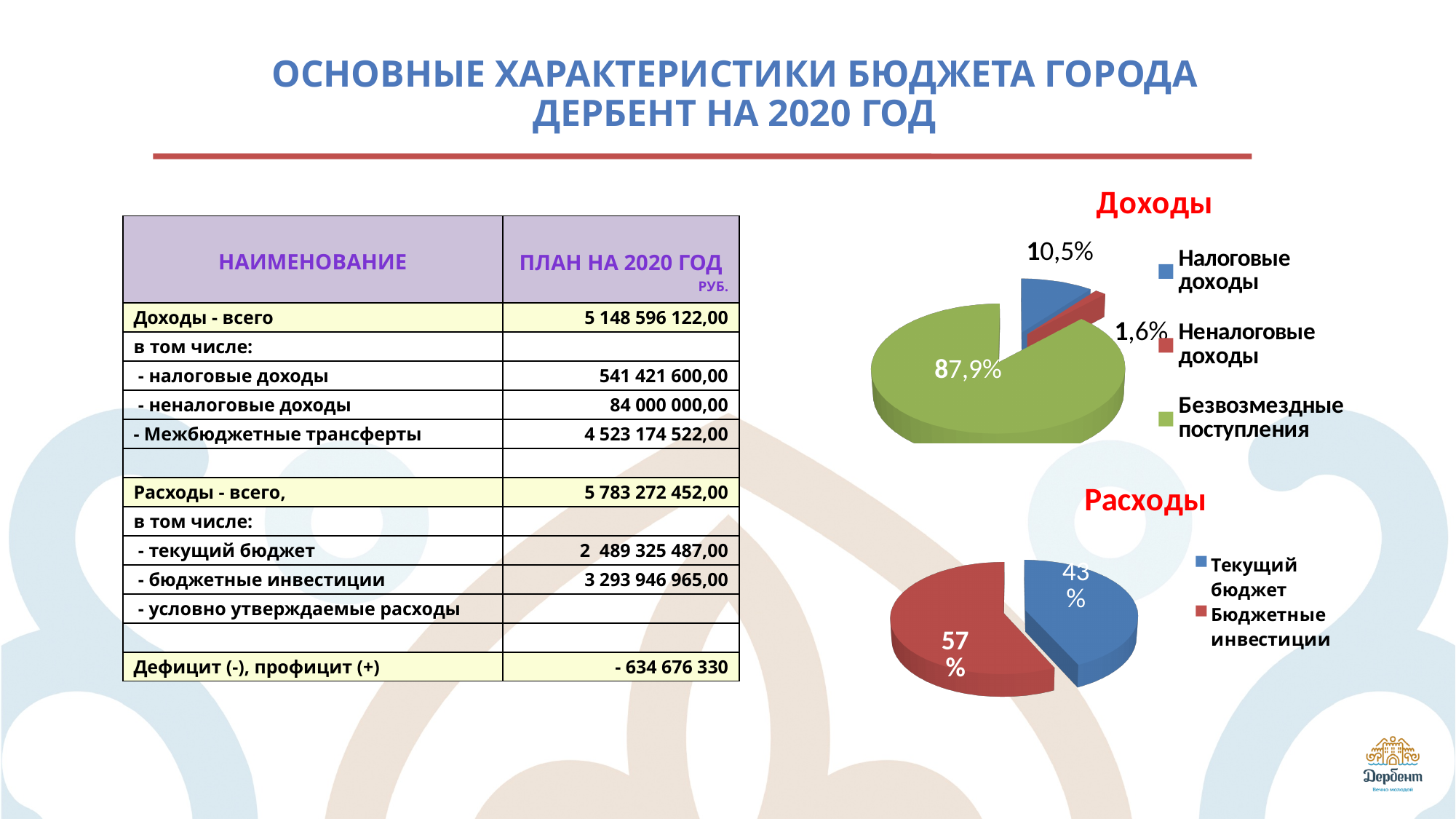
In the "Доходы" pie chart, what share is shown for "Налоговые доходы"? 10,5% In the "Доходы" pie chart, what colour is the "Безвозмездные поступления" slice? Green In the "Доходы" pie chart, which category has the largest slice? Безвозмездные поступления In the "Расходы" pie chart, what is the difference in percentage points between "Бюджетные инвестиции" and "Текущий бюджет"? 14 In the "Расходы" pie chart, which is larger: "Текущий бюджет" or "Бюджетные инвестиции"? Бюджетные инвестиции In the "Расходы" pie chart, what share is shown for "Бюджетные инвестиции"? 57% What type of chart is the "Расходы" chart? Pie chart In the "Расходы" pie chart, what share is shown for "Текущий бюджет"? 43% In the "Доходы" pie chart, which category has the smallest slice? Неналоговые доходы In the "Доходы" pie chart, what share is shown for "Неналоговые доходы"? 1,6% In the "Доходы" pie chart, how many categories does the legend list? 3 In the "Доходы" pie chart, what share is shown for "Безвозмездные поступления"? 87,9%